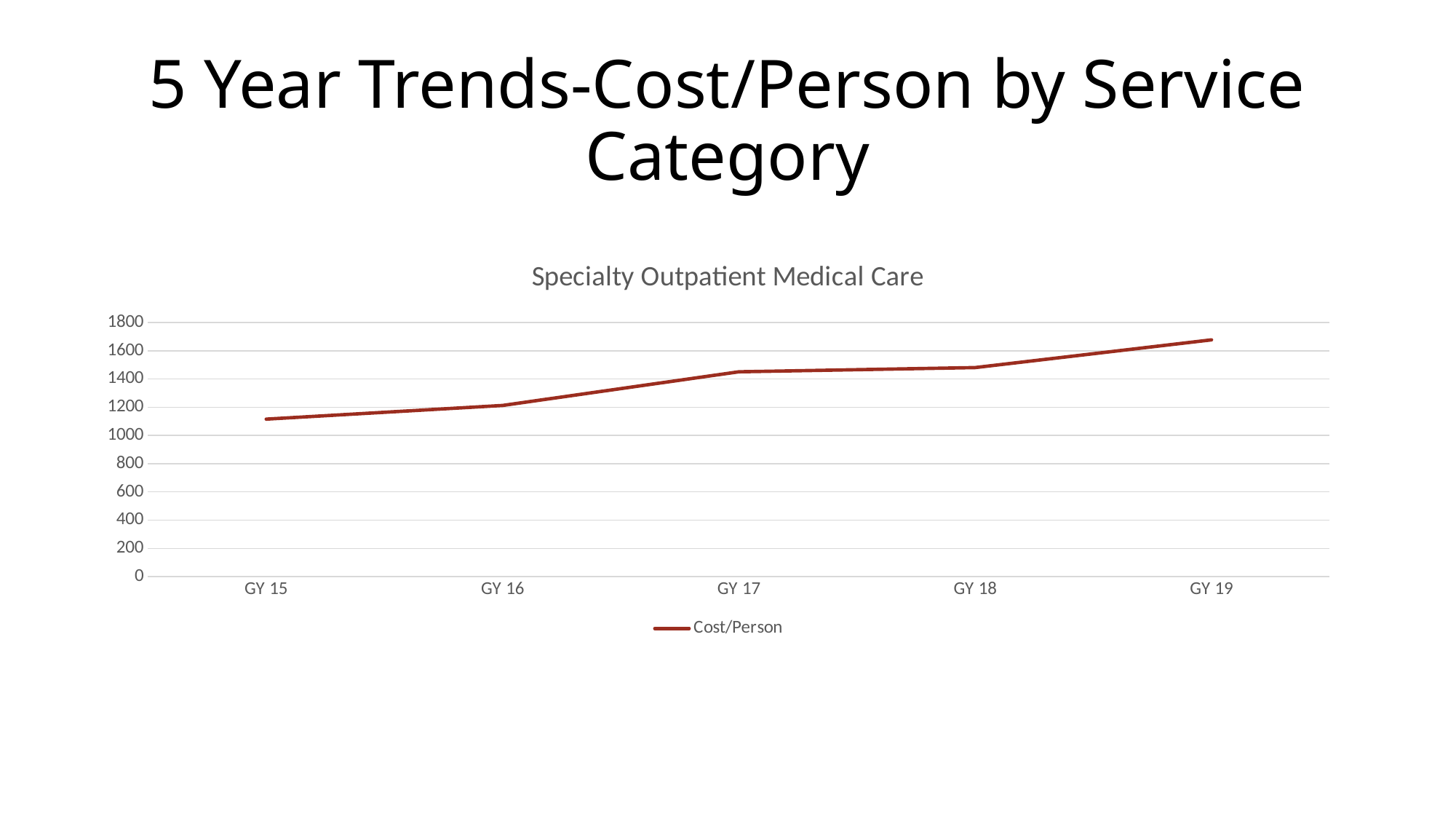
What type of chart is shown on the slide? line chart Is the Cost/Person for GY 15 greater or less than 1200? less Which year has the highest Cost/Person? GY 19 Does the Cost/Person rise or fall from GY 15 to GY 19? rise Which year has the larger Cost/Person, GY 16 or GY 17? GY 17 Is the Cost/Person for GY 19 greater or less than 1600? greater How many series does the legend list? 1 Is the Cost/Person for GY 17 greater or less than 1400? greater How many years (data points) are plotted on the x axis? 5 What is the title of the chart? Specialty Outpatient Medical Care What is the name of the series shown in the legend? Cost/Person Which year has the lowest Cost/Person? GY 15